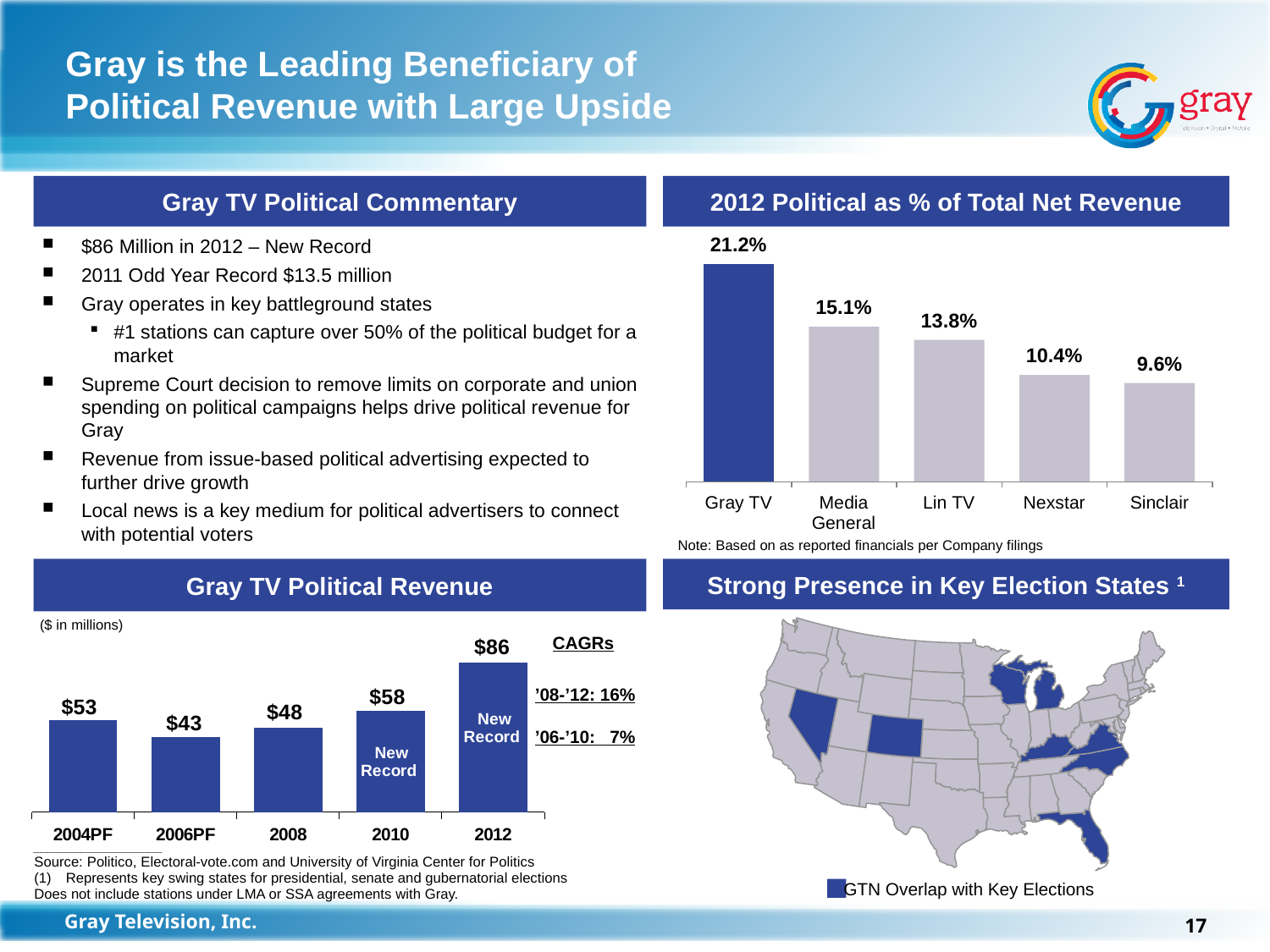
In the '2012 Political as % of Total Net Revenue' chart, which is larger, Lin TV or Nexstar? Lin TV In the '2012 Political as % of Total Net Revenue' chart, what is the difference between Media General and Lin TV? 1.3% In the '2012 Political as % of Total Net Revenue' chart, which company has the lowest value? Sinclair In the '2012 Political as % of Total Net Revenue' chart, what is the value for Nexstar? 10.4% In the 'Gray TV Political Revenue' chart, what is the difference between 2012 and 2004PF? $33 In the 'Gray TV Political Revenue' chart, what is the '08-'12 CAGR shown? 16% In the 'Gray TV Political Revenue' chart, which year has the highest value? 2012 In the 'Gray TV Political Revenue' chart, what is the value for 2010? $58 In the 'Gray TV Political Revenue' chart, what is the value for 2006PF? $43 In the '2012 Political as % of Total Net Revenue' chart, how many companies are shown? 5 In the '2012 Political as % of Total Net Revenue' chart, what is the value for Gray TV? 21.2% What kind of chart is the 'Gray TV Political Revenue' chart? Bar chart